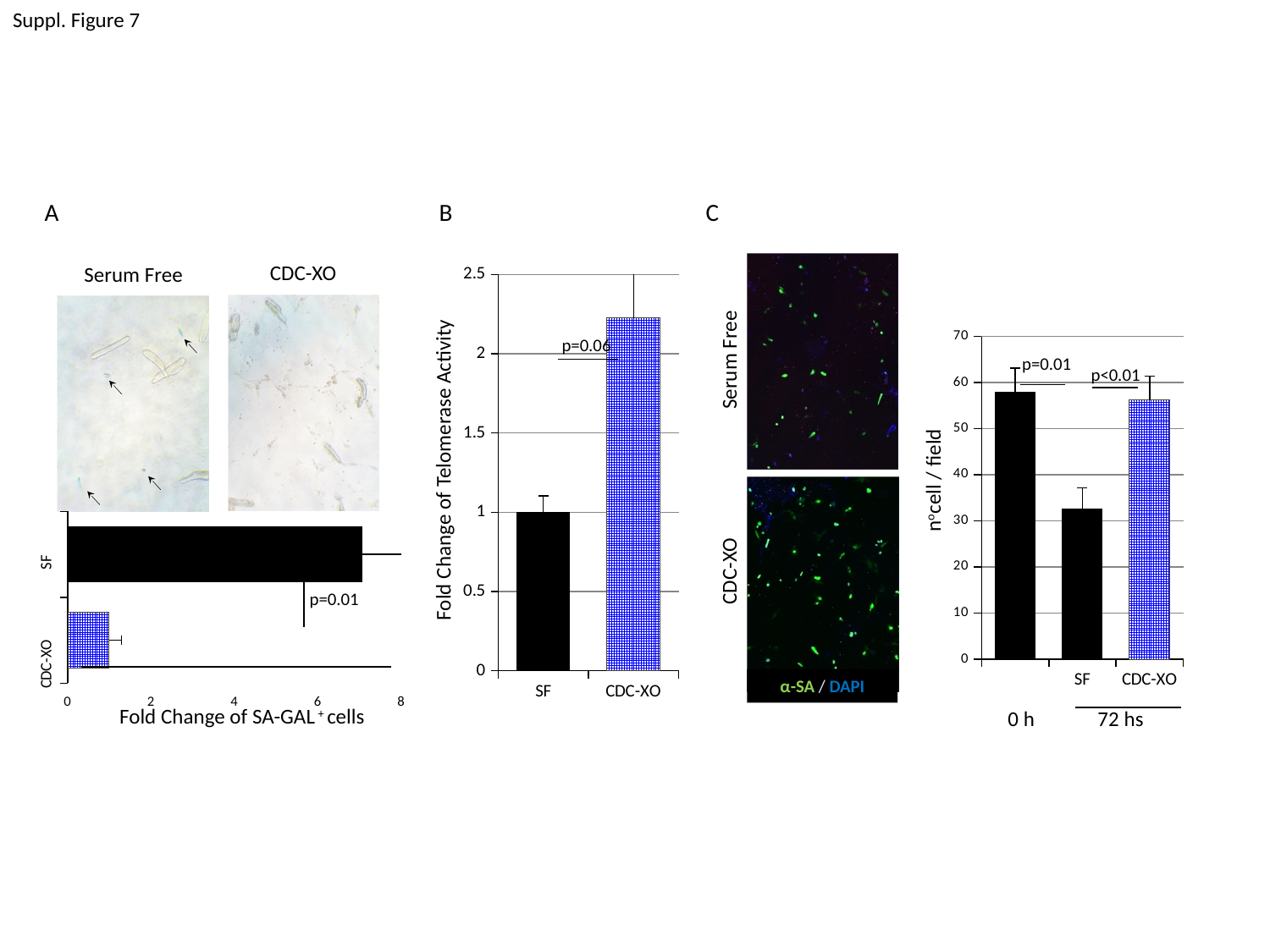
In chart C (n° cell / field), which is larger, the value for SF or the value for CDC-XO? CDC-XO In chart C (n° cell / field), is the value for SF greater or less than 40? less What is the y-axis title of chart B? Fold Change of Telomerase Activity In chart A (Fold Change of SA-GAL+ cells), is the value for SF greater or less than 6? greater In chart B (Fold Change of Telomerase Activity), which category has the highest value? CDC-XO How many bars are plotted in chart C (n° cell / field)? 3 In chart A (Fold Change of SA-GAL+ cells), is the value for CDC-XO greater or less than 2? less In chart A (Fold Change of SA-GAL+ cells), which category has the higher value, SF or CDC-XO? SF In chart C (n° cell / field), which category has the lowest value? SF What kind of chart is chart B (Fold Change of Telomerase Activity)? bar chart